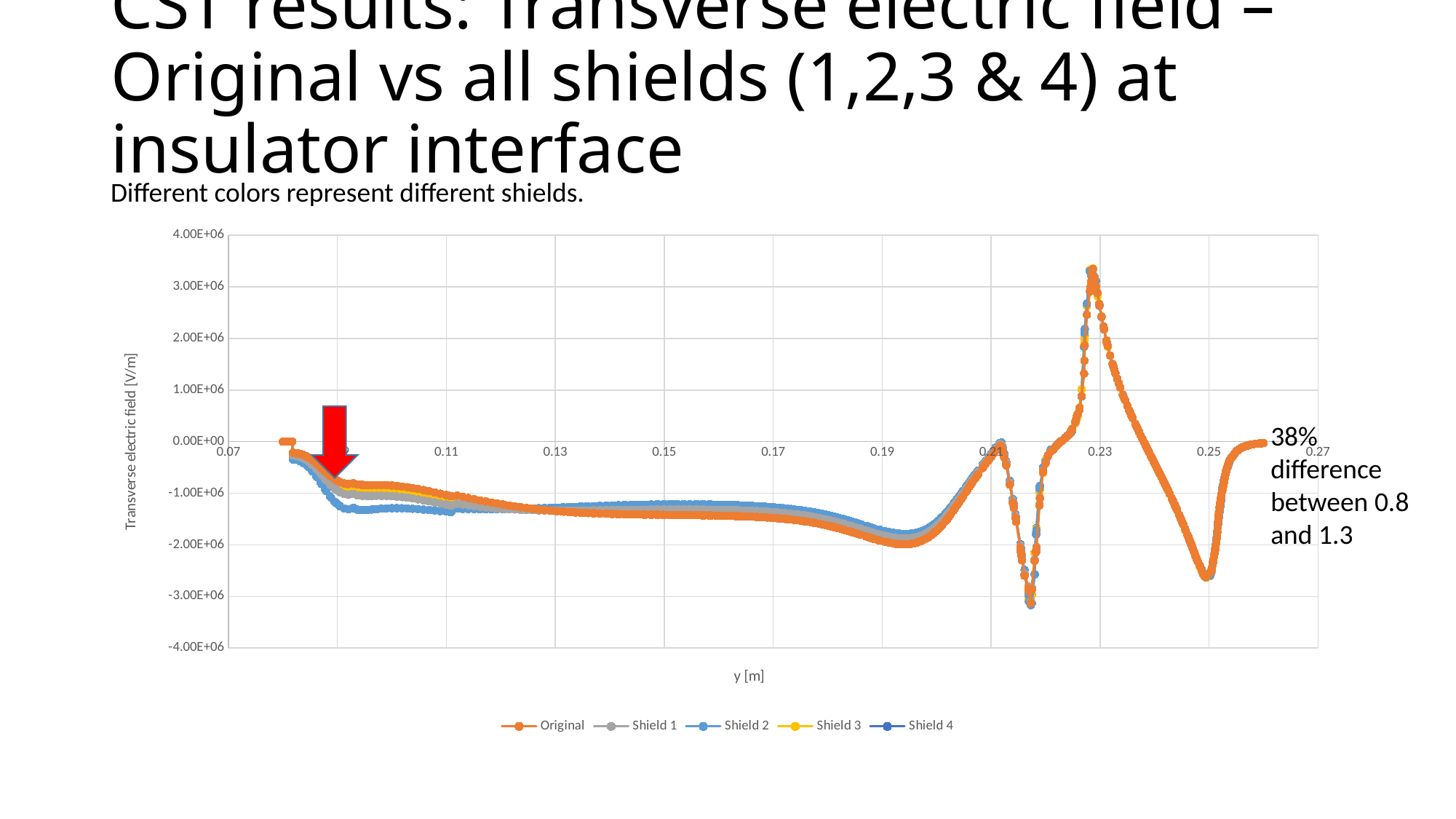
Do the values rise or fall along the x axis between y = 0.23 and y = 0.25? fall Do the values rise or fall along the x axis between y = 0.15 and y = 0.19? fall What is the label of the y axis? Transverse electric field [V/m] How many series does the legend list? 5 What is the label of the x axis? y [m] Is the value of the Original series at y = 0.15 greater or less than -1.00E+06? less Is the peak value of the curves near y = 0.23 greater or less than 3.00E+06? greater Is the value of the Original series at y = 0.19 greater or less than -1.00E+06? less What kind of chart is shown on the slide? line chart Do the values rise or fall along the x axis between y = 0.19 and y = 0.21? rise